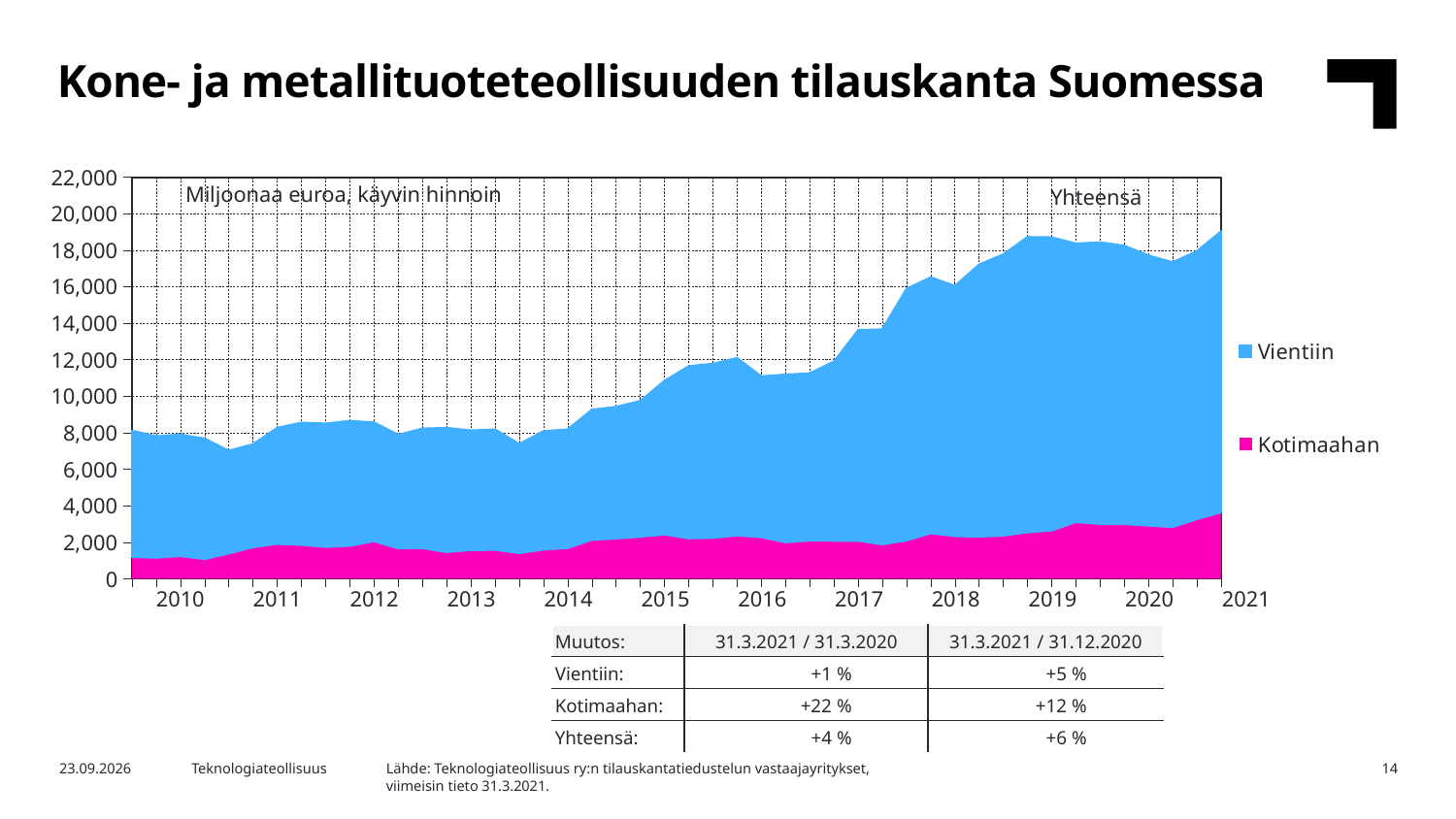
Is the total (Yhteensä) value at the end of the chart in 2021 greater or less than 18,000? greater What unit is stated in the label at the top left of the chart? Miljoonaa euroa, käyvin hinnoin How many series does the legend list? 2 Does the total order backlog (Yhteensä) rise or fall overall from 2010 to 2021? Rise Is the total (Yhteensä) value at the start of 2013 greater or less than 10,000? less How many year labels are shown on the x axis? 12 Which series is larger throughout the chart, Vientiin or Kotimaahan? Vientiin What kind of chart is shown on the slide? Stacked area chart Is the Kotimaahan value at the end of the chart in 2021 greater or less than 2,000? greater Which two series are listed in the chart legend? Vientiin and Kotimaahan